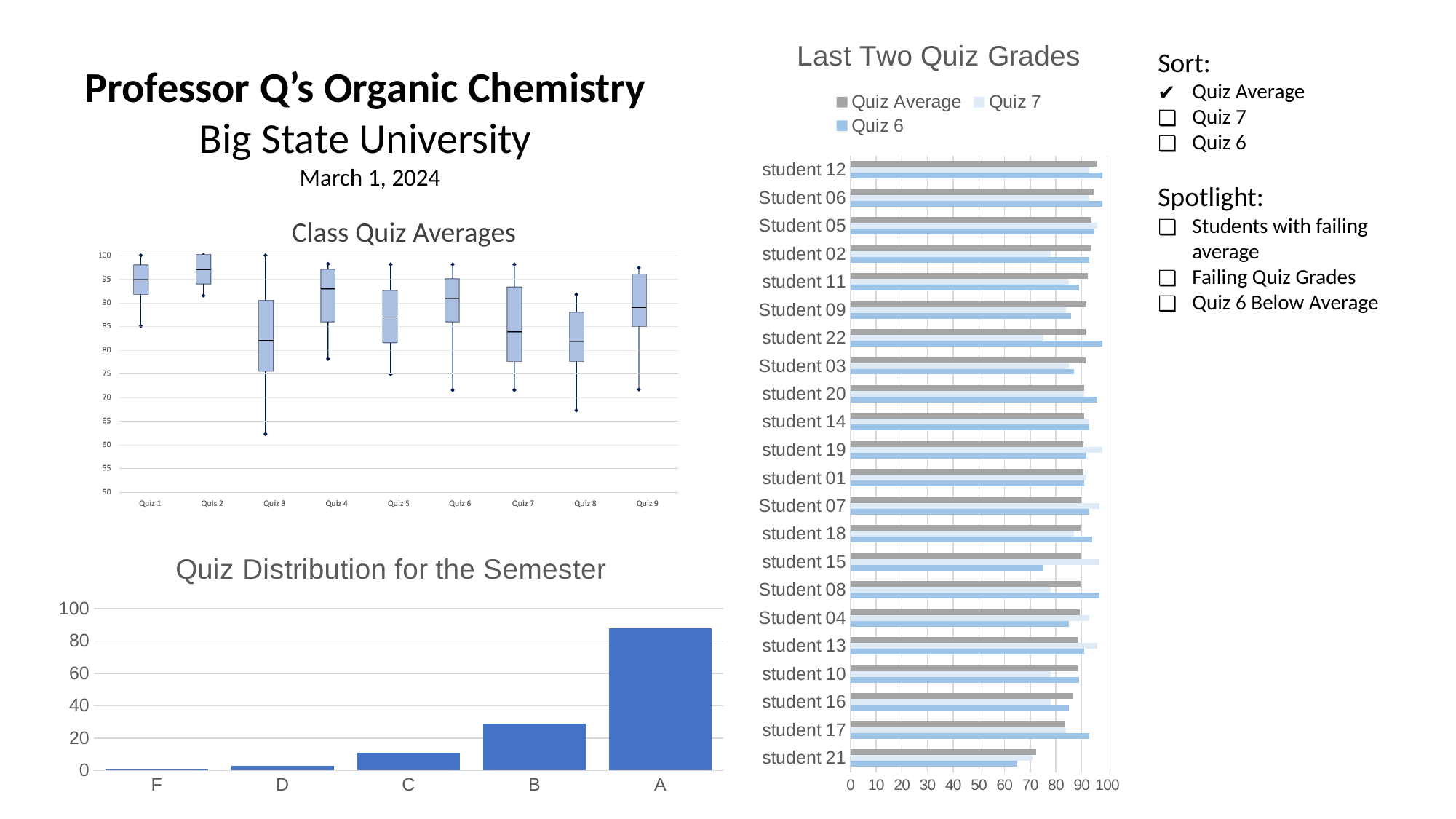
How many series does the legend of "Last Two Quiz Grades" list? 3 In "Last Two Quiz Grades", is the Quiz 6 value for student 21 greater or less than 70? less What kind of chart is "Quiz Distribution for the Semester"? bar chart In "Quiz Distribution for the Semester", is the value for B greater or less than 40? less In "Quiz Distribution for the Semester", is the value for A greater or less than 80? greater In "Quiz Distribution for the Semester", which grade category has the highest value? A In "Quiz Distribution for the Semester", do the values rise or fall moving from F to A along the x axis? rise How many quizzes are shown on the x axis of "Class Quiz Averages"? 9 In "Last Two Quiz Grades", which student has the lowest Quiz Average? student 21 How many grade categories are shown in "Quiz Distribution for the Semester"? 5 In "Quiz Distribution for the Semester", which grade category has the lowest value? F How many students are shown in "Last Two Quiz Grades"? 22